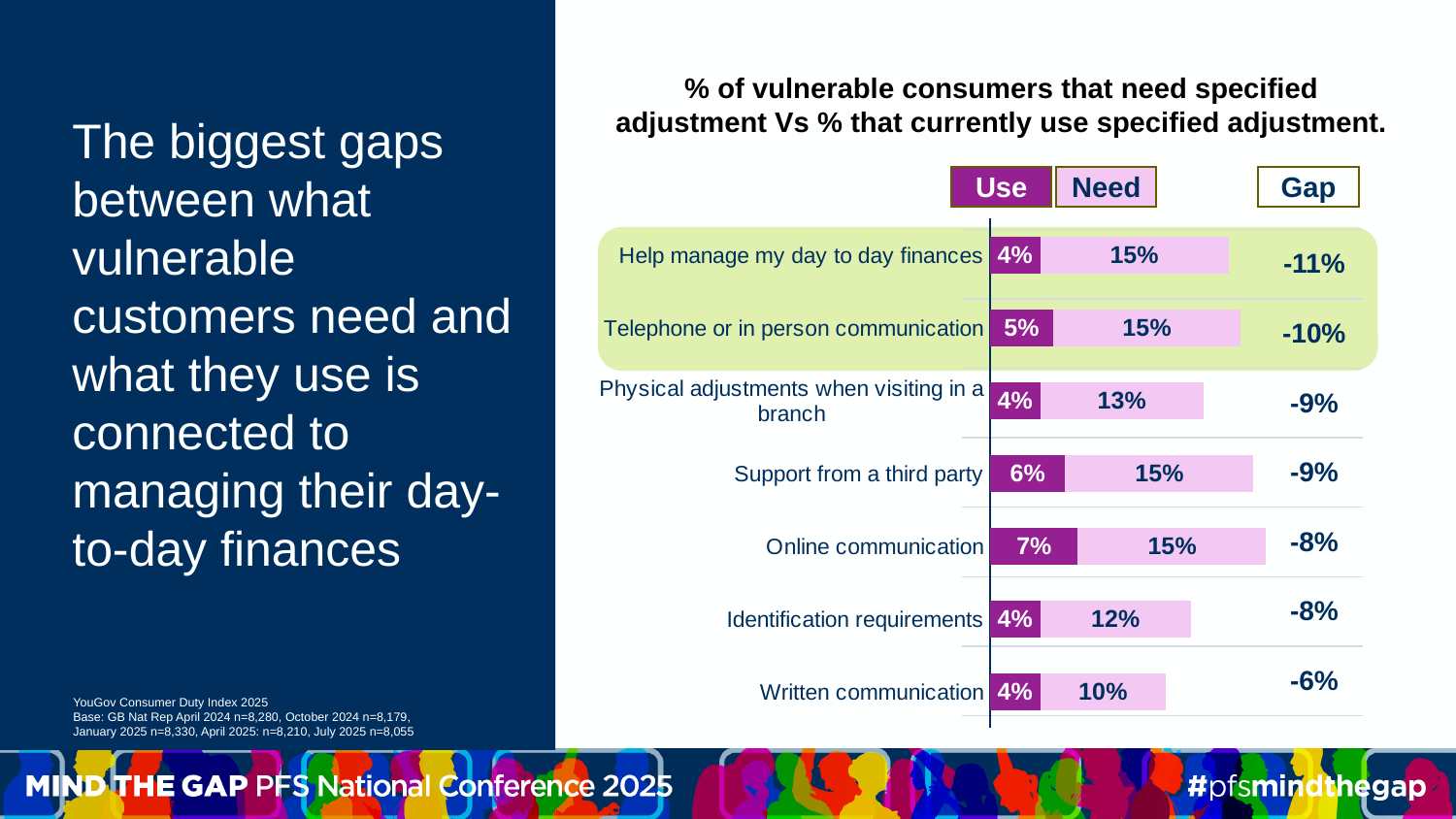
Which adjustment has the largest gap between need and use? Help manage my day to day finances Which adjustment has the highest Use value? Online communication What type of chart is shown on the slide? Bar chart What percentage of vulnerable consumers need telephone or in person communication? 15% Is the Use value higher for online communication or for identification requirements? Online communication What is the difference between the Need and Use values for support from a third party? 9% What is the title of the chart? % of vulnerable consumers that need specified adjustment Vs % that currently use specified adjustment. What is the gap shown for physical adjustments when visiting in a branch? -9% How many adjustments are listed in the chart? 7 What is the Need value for written communication? 10% Which adjustment has the lowest Need value? Written communication What percentage of vulnerable consumers currently use help to manage their day to day finances? 4%